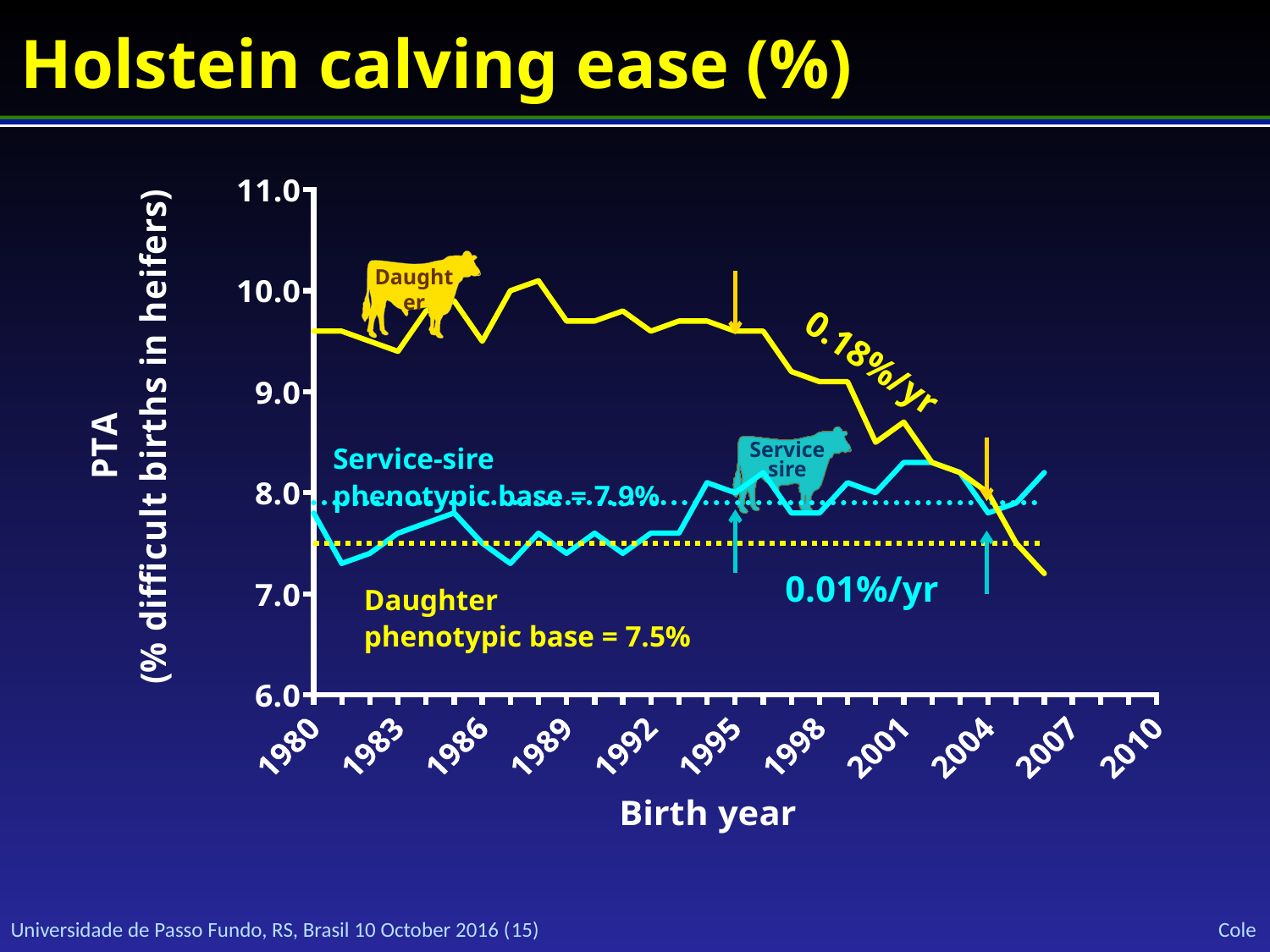
What is the label of the x axis? Birth year Which series has the higher value in birth year 1990, Daughter or Service sire? Daughter Is the Daughter value for birth year 1980 greater or less than 9.0? greater What is the Service-sire phenotypic base shown on the chart? 7.9% Is the Daughter value for birth year 2006 greater or less than 8.0? less What is the title of the slide's chart? Holstein calving ease (%) Is the Service sire value for birth year 1982 greater or less than 7.5? less Does the Daughter (yellow) line rise or fall from 1980 to 2006? fall How many series are plotted on the chart? 4 What is the Daughter phenotypic base shown on the chart? 7.5% What kind of chart is shown on the slide? line chart Which series has the higher value in birth year 2006, Daughter or Service sire? Service sire